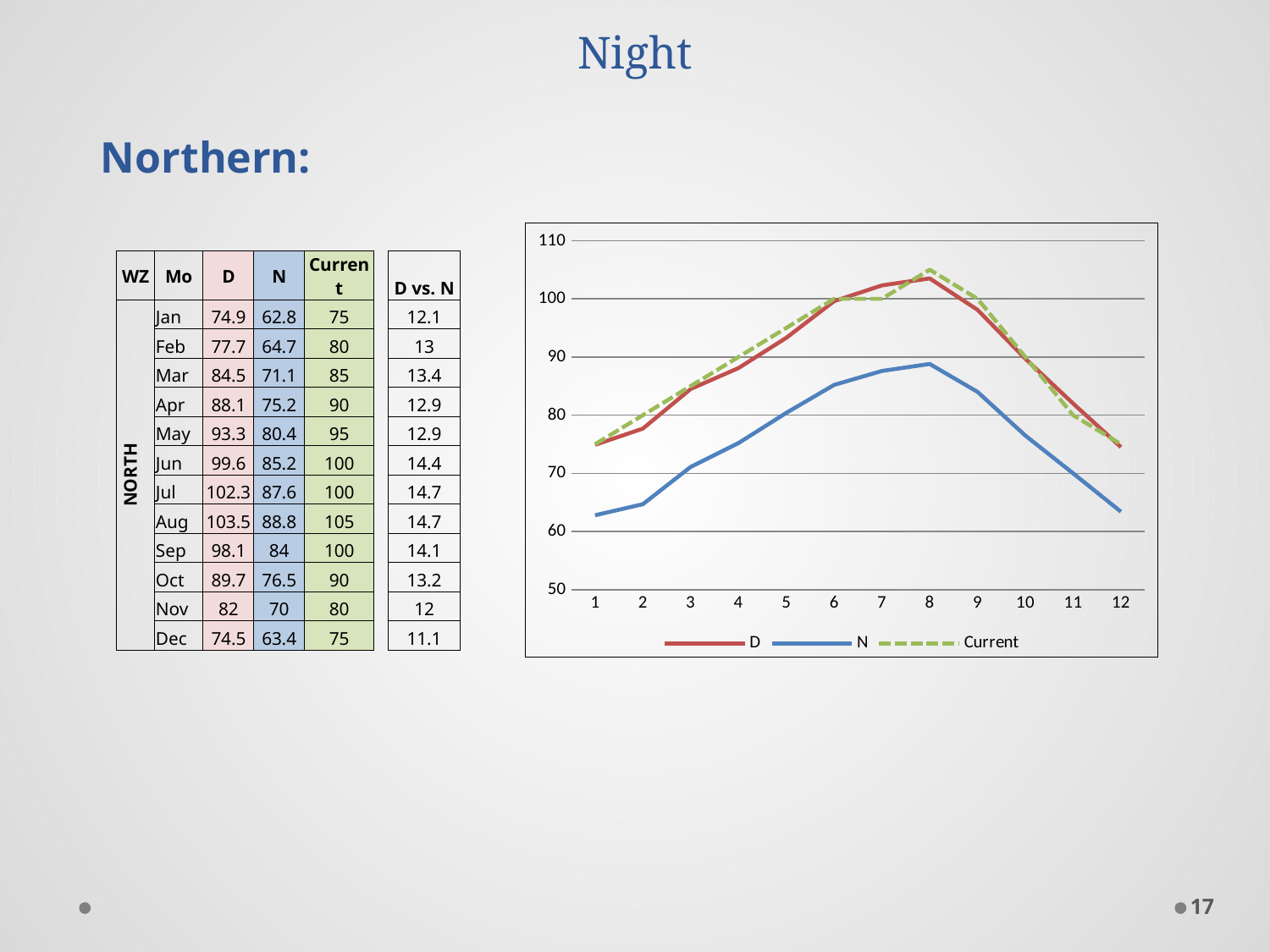
Does the N series rise or fall from point 1 to point 8? rise Is the value of N at point 12 greater or less than 70? less According to the table, what is the D vs. N difference for Aug? 14.7 How many points are plotted along the x axis of the chart? 12 How many series does the chart legend list? 3 According to the table, which month has the highest D value? Aug At point 6, which is larger, D or N? D Which series stays lowest across the whole chart? N What kind of chart is shown on the slide? line chart Is the value of D at point 8 greater or less than 100? greater According to the table, what is the D value for Jul? 102.3 Which series in the chart is drawn with a dashed line? Current